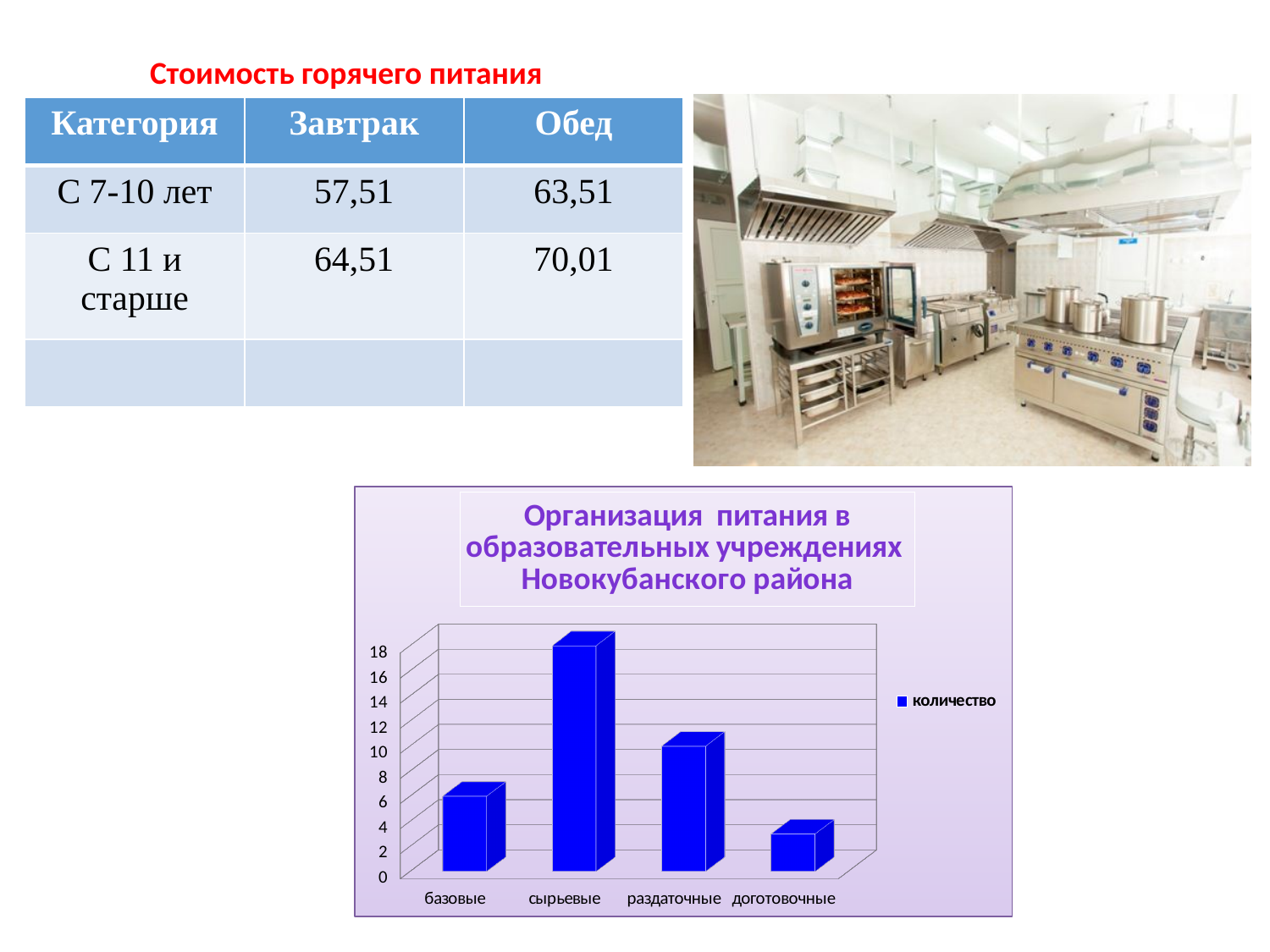
What kind of chart is shown on the slide? bar chart What is the name of the series in the chart legend? количество How many categories are shown on the x axis of the chart? 4 Is the value for раздаточные greater or less than 8? greater Which is larger, the value for базовые or the value for раздаточные? раздаточные How many series does the chart legend list? 1 Which category has the highest value in the chart? сырьевые Which category has the lowest value in the chart? доготовочные Is the value for доготовочные greater or less than 6? less Is the value for сырьевые greater or less than 16? greater What is the title of the chart? Организация питания в образовательных учреждениях Новокубанского района